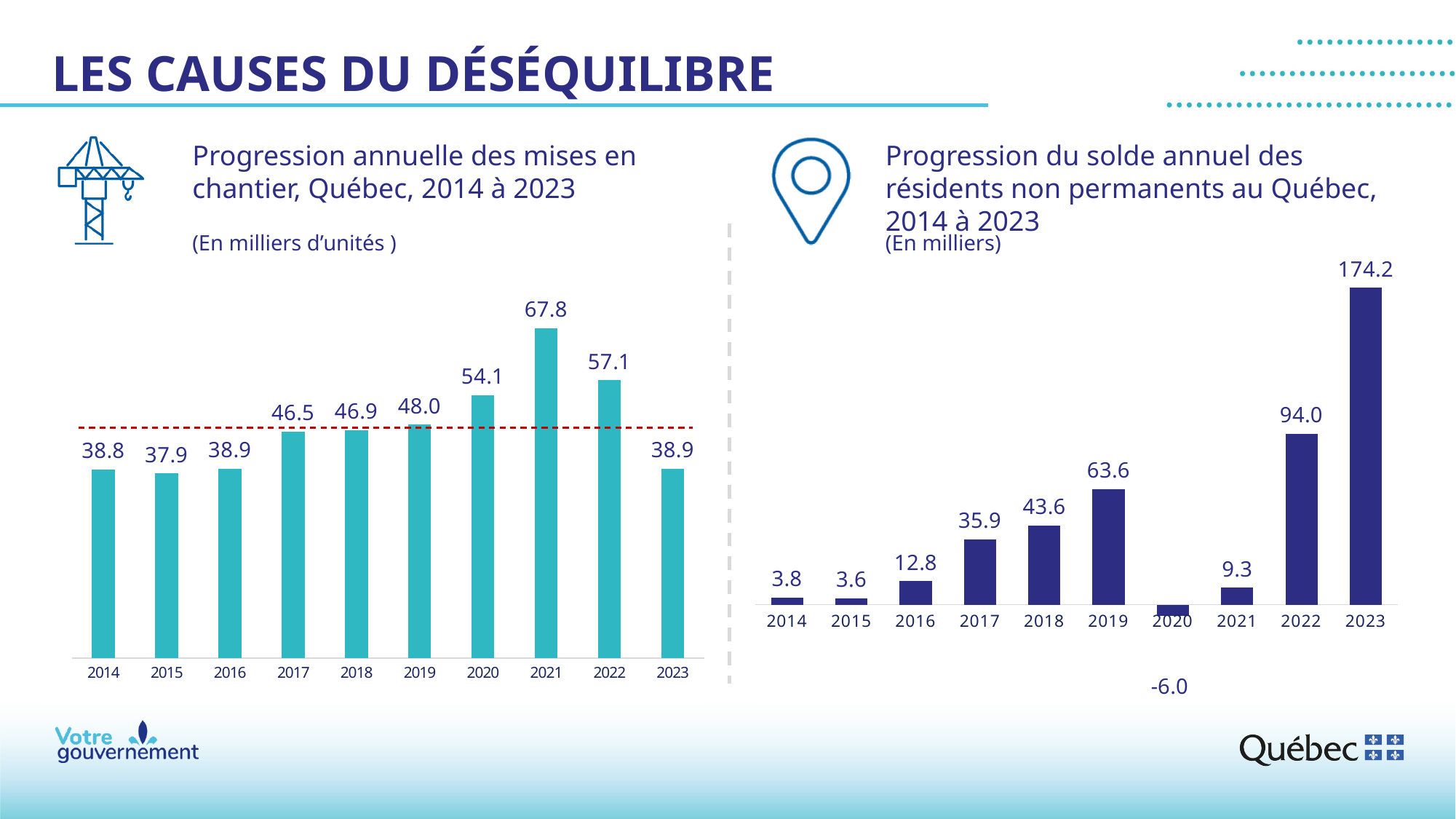
In the right chart (Progression du solde annuel des résidents non permanents), which year has the lowest value? 2020 In the left chart (Progression annuelle des mises en chantier), what is the value for 2021? 67.8 In the left chart (Progression annuelle des mises en chantier), which year has the lowest value? 2015 What kind of chart is the right chart (Progression du solde annuel des résidents non permanents)? Bar chart In the right chart (Progression du solde annuel des résidents non permanents), what is the difference between the 2023 and 2022 values? 80.2 In the right chart (Progression du solde annuel des résidents non permanents), what is the value for 2020? -6.0 In the left chart (Progression annuelle des mises en chantier), how many years are shown on the x axis? 10 In the left chart (Progression annuelle des mises en chantier), what is the difference between the 2021 and 2022 values? 10.7 What unit is stated under the title of the left chart? En milliers d'unités In the left chart (Progression annuelle des mises en chantier), what is the value for 2023? 38.9 In the right chart (Progression du solde annuel des résidents non permanents), which is larger, the value for 2019 or the value for 2022? 2022 In the right chart (Progression du solde annuel des résidents non permanents), what is the value for 2023? 174.2